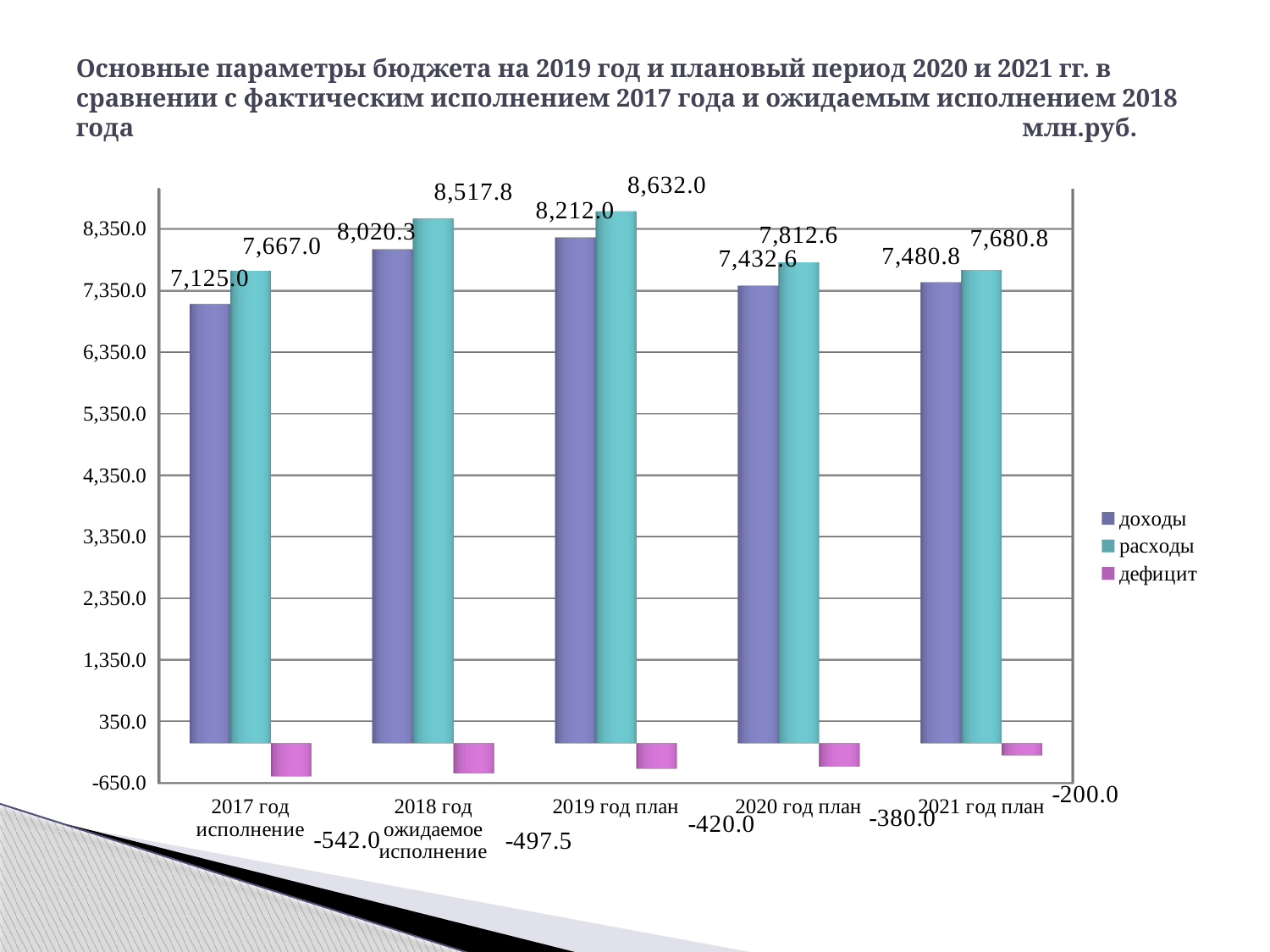
Which category has the highest value of расходы? 2019 год план How many categories are shown on the x axis? 5 Is the value of расходы for 2017 год исполнение greater or less than 7,350.0? greater What is the difference between расходы and доходы for 2020 год план? 380.0 What unit is stated in the chart title? млн.руб. What is the value of доходы for 2019 год план? 8,212.0 What is the value of расходы for 2018 год ожидаемое исполнение? 8,517.8 What type of chart is shown on the slide? bar chart What is the value of дефицит for 2021 год план? -200.0 Which is larger: доходы for 2021 год план or доходы for 2020 год план? доходы for 2021 год план Which category has the lowest value of доходы? 2017 год исполнение How many series does the legend list? 3